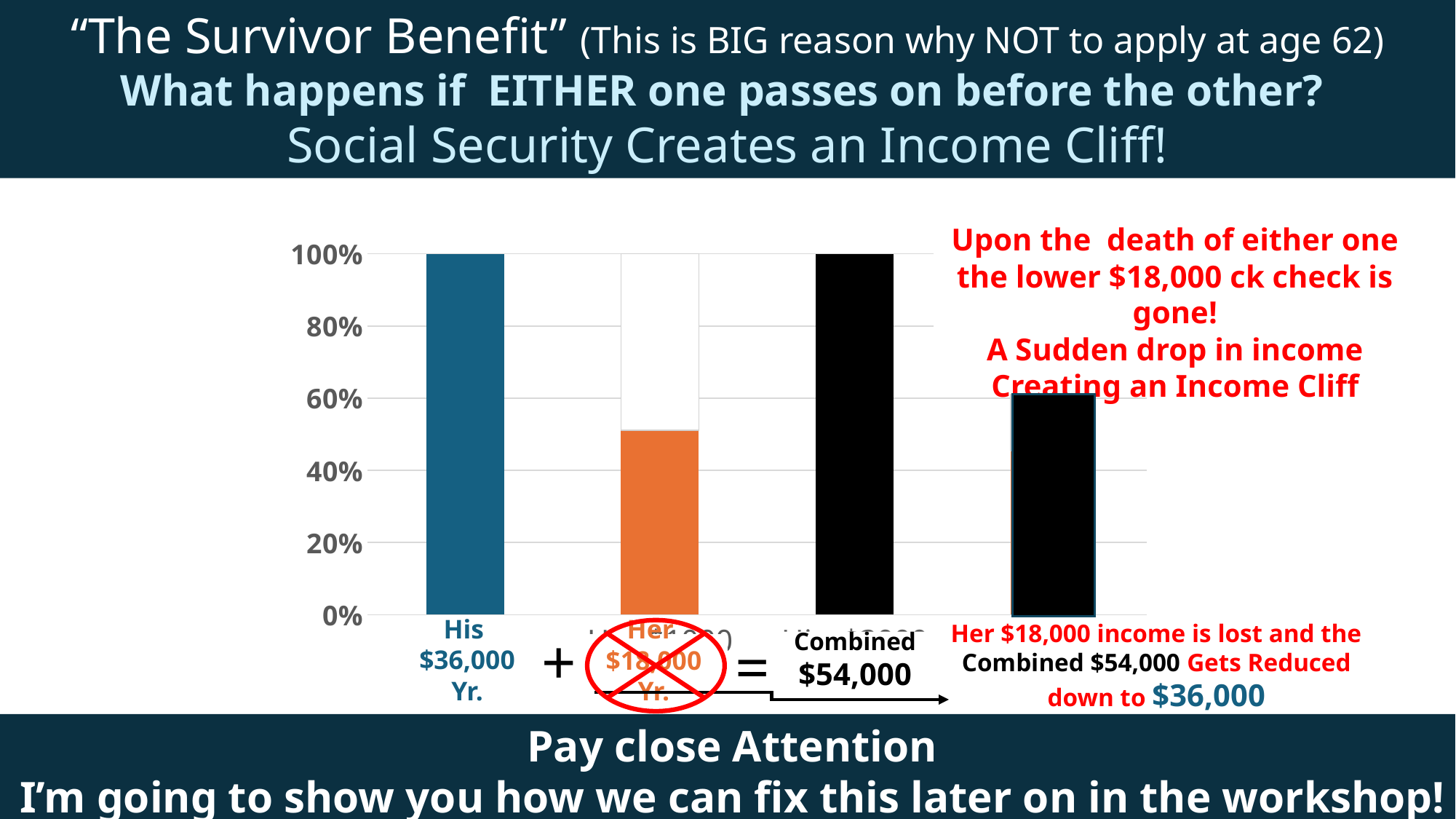
What value does the 'Combined' bar reach on the percentage axis? 100% What annual dollar amount is labeled for the 'Combined' benefit? $54,000 What colour is the 'Her' bar? orange What annual dollar amount is labeled for 'His' benefit? $36,000 Is the value of the rightmost black bar (the reduced income bar) greater or less than 80%? less How many bars are plotted in the chart? 4 Is the value of the 'Her' bar greater or less than 60%? less Is the value of the 'Her' bar greater or less than 40%? greater Which bar in the chart is the shortest? Her Which bar is taller, 'His' or 'Her'? His What kind of chart is shown on the slide? bar chart What value does the 'His' bar reach on the percentage axis? 100%